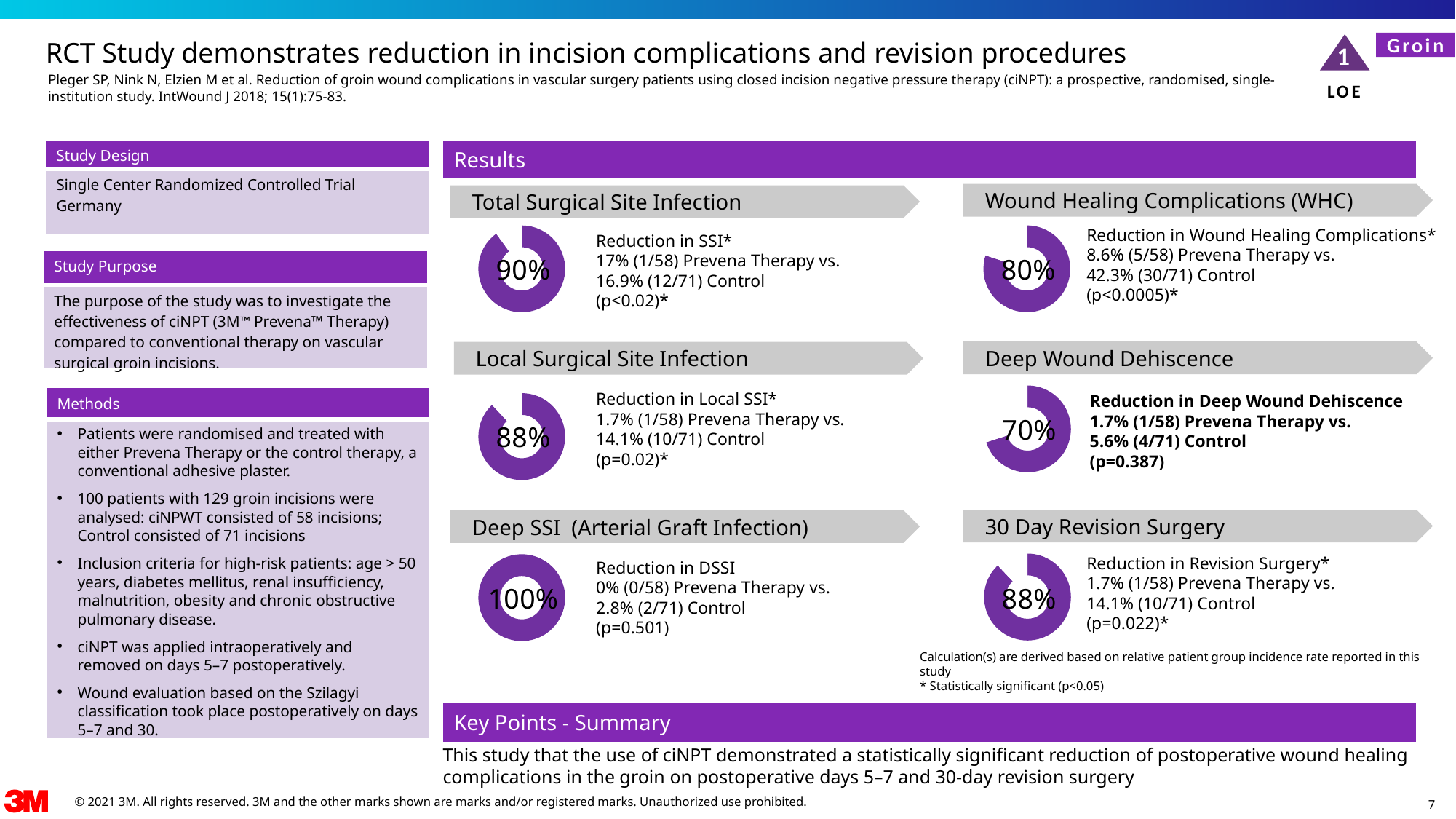
How many donut charts are shown in the Results section of the slide? 6 Which of the six donut charts in the Results section shows the highest percentage? Deep SSI (Arterial Graft Infection) What percentage is shown in the donut chart under "Deep Wound Dehiscence"? 70% What percentage is shown in the donut chart under "Total Surgical Site Infection"? 90% What percentage is shown in the donut chart under "Wound Healing Complications (WHC)"? 80% What type of chart is used to display the reduction percentages in the Results section? Donut chart What percentage is shown in the donut chart under "Deep SSI (Arterial Graft Infection)"? 100% What percentage is shown in the donut chart under "Local Surgical Site Infection"? 88% Which shows a larger percentage: the "Wound Healing Complications (WHC)" donut chart or the "Local Surgical Site Infection" donut chart? Local Surgical Site Infection Which of the six donut charts in the Results section shows the lowest percentage? Deep Wound Dehiscence What is the difference between the percentage in the "Total Surgical Site Infection" donut chart and the percentage in the "Deep Wound Dehiscence" donut chart? 20% What percentage is shown in the donut chart under "30 Day Revision Surgery"? 88%